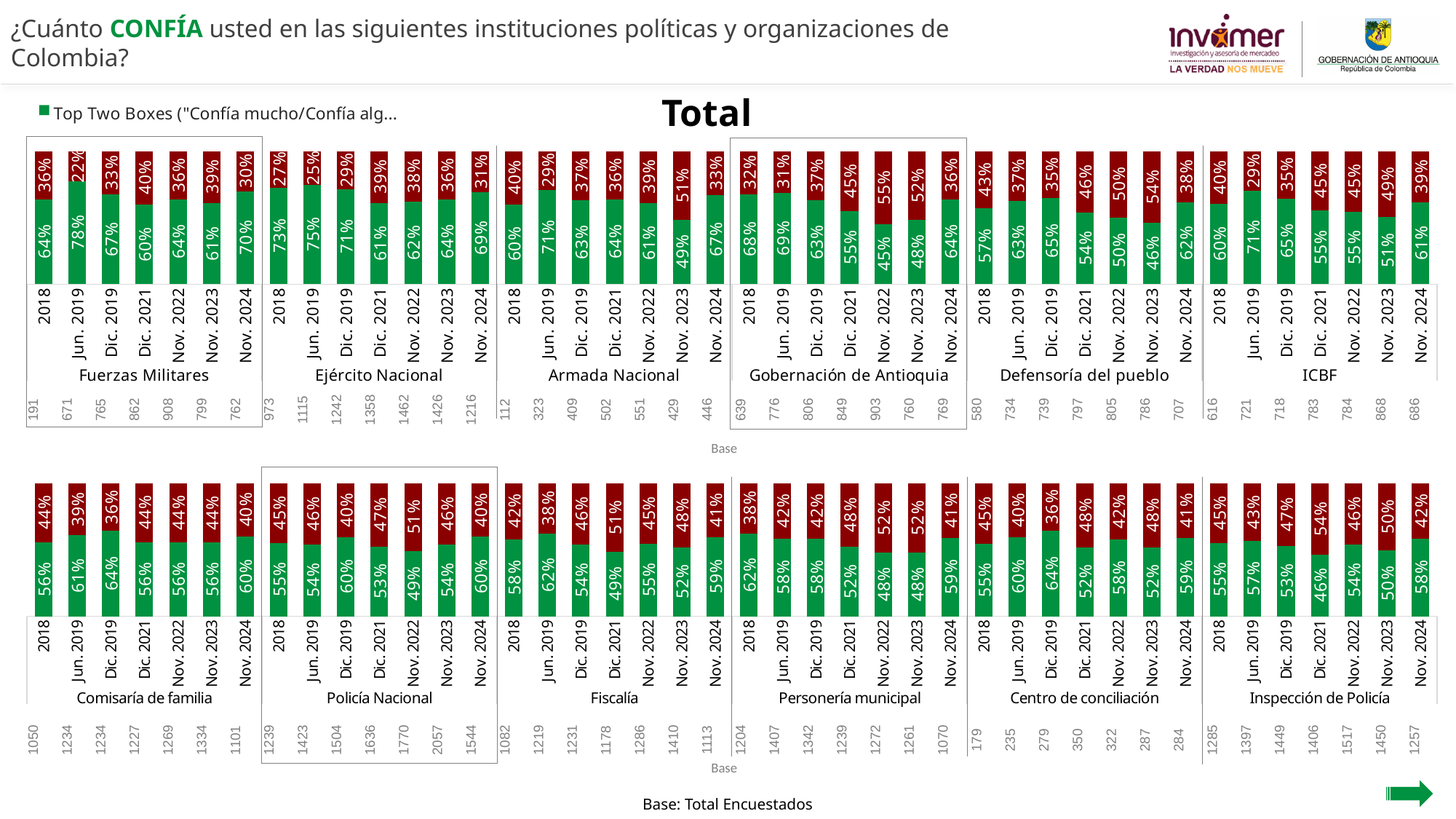
In the top chart, which period has the highest green Top Two Boxes value for Gobernación de Antioquia? Jun. 2019 In the top chart, what is the green Top Two Boxes value for Fuerzas Militares in Jun. 2019? 78% In the top chart, which period has the lowest green Top Two Boxes value for Armada Nacional? Nov. 2023 In the top chart, what is the difference between the green Top Two Boxes values for Fuerzas Militares in Jun. 2019 and Dic. 2021? 18% In the top chart, does the green Top Two Boxes value for Gobernación de Antioquia rise or fall from 2018 to Nov. 2022? Fall What kind of chart is used on this slide? Stacked bar chart In the bottom chart, what is the total of the green and red segments for Comisaría de familia in 2018? 100% In the bottom chart, what is the green Top Two Boxes value for Policía Nacional in Nov. 2022? 49% How many institutions are shown in the top chart? 6 In the bottom chart, which is larger: the green Top Two Boxes value for Fiscalía in Jun. 2019 or for Inspección de Policía in Jun. 2019? Fiscalía in Jun. 2019 What is the base (number of respondents) shown for Policía Nacional in Nov. 2023 in the bottom chart? 2057 In the top chart, what is the green Top Two Boxes value for Gobernación de Antioquia in Nov. 2024? 64%